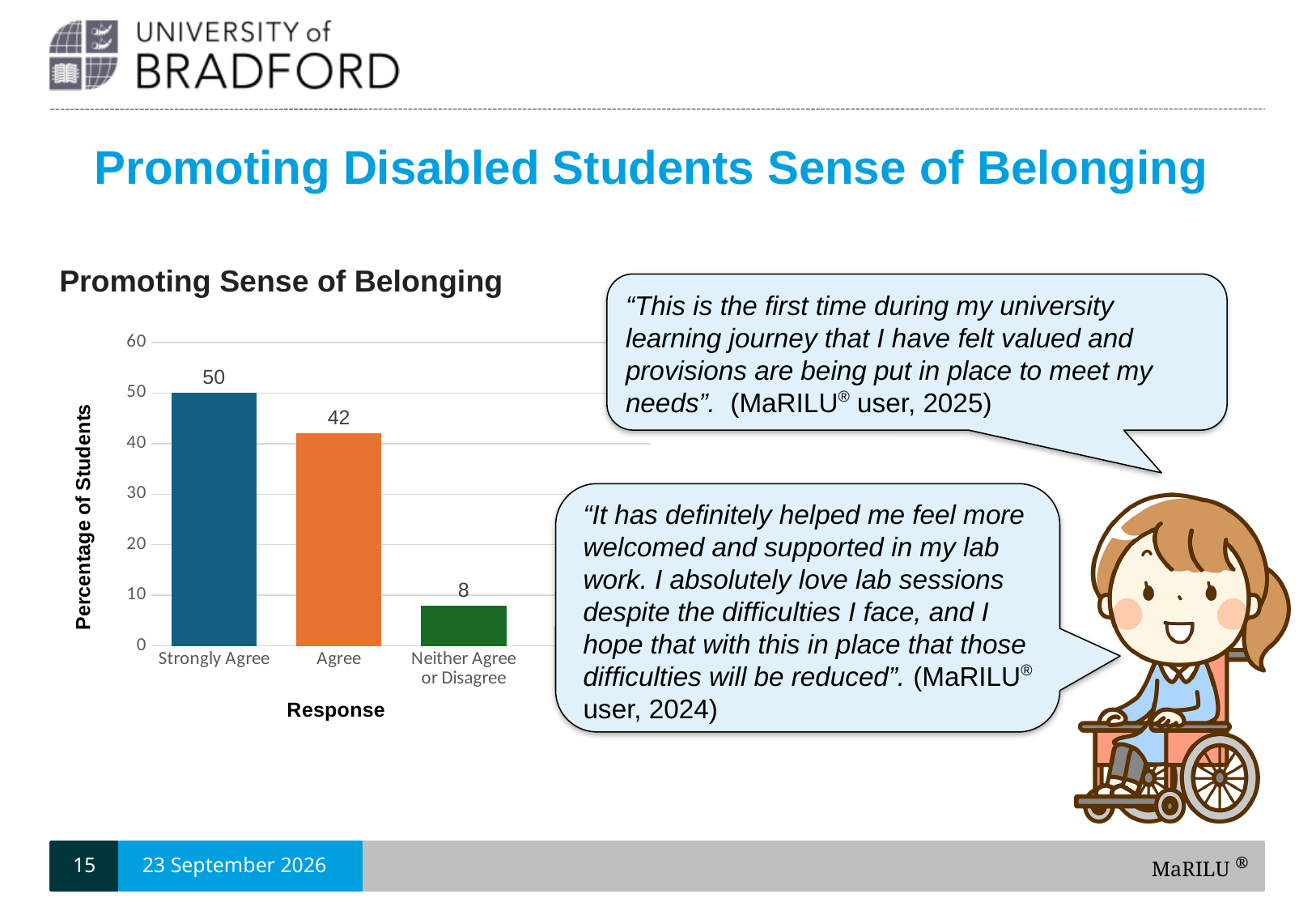
What is the label of the vertical axis of the chart? Percentage of Students What is the title of the chart on the slide? Promoting Sense of Belonging What is the difference between the 'Agree' and 'Neither Agree or Disagree' values? 34 Which visible response category has the lowest percentage of students? Neither Agree or Disagree What percentage of students responded 'Strongly Agree' in the Promoting Sense of Belonging chart? 50 What kind of chart is shown on the slide? Bar chart Which visible response category has the highest percentage of students? Strongly Agree What is the difference between the 'Strongly Agree' and 'Agree' values? 8 What is the value for 'Agree' in the Promoting Sense of Belonging chart? 42 Is the value for 'Neither Agree or Disagree' greater or less than 10? less What is the value for 'Neither Agree or Disagree' in the Promoting Sense of Belonging chart? 8 Which is larger, the value for 'Strongly Agree' or the value for 'Agree'? Strongly Agree